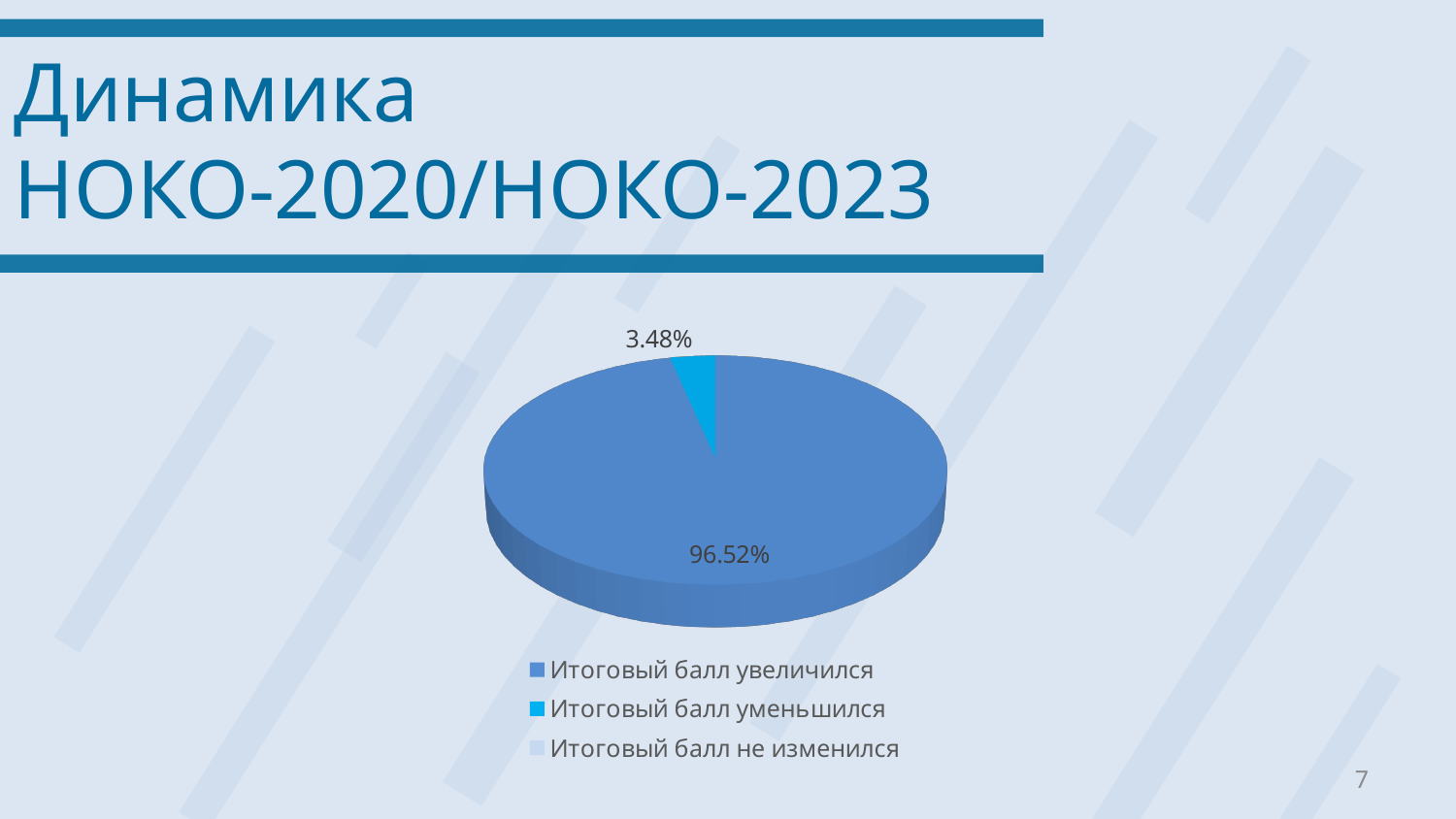
Which category has the largest slice of the pie? Итоговый балл увеличился Is the share for "Итоговый балл увеличился" greater or less than 50%? greater What is the difference in percentage points between the "Итоговый балл увеличился" slice and the "Итоговый балл уменьшился" slice? 93.04% How many entries does the chart legend list? 3 What share of the pie is labelled "Итоговый балл уменьшился"? 3.48% Which of the labelled slices is the smallest? Итоговый балл уменьшился Which legend entry is shown in the lightest blue colour? Итоговый балл не изменился What share of the pie is labelled "Итоговый балл увеличился"? 96.52% Is the share for "Итоговый балл уменьшился" greater or less than 10%? less What kind of chart is shown on the slide? Pie chart Which is larger: the slice for "Итоговый балл увеличился" or the slice for "Итоговый балл уменьшился"? Итоговый балл увеличился What is the title of the slide containing the chart? Динамика НОКО-2020/НОКО-2023